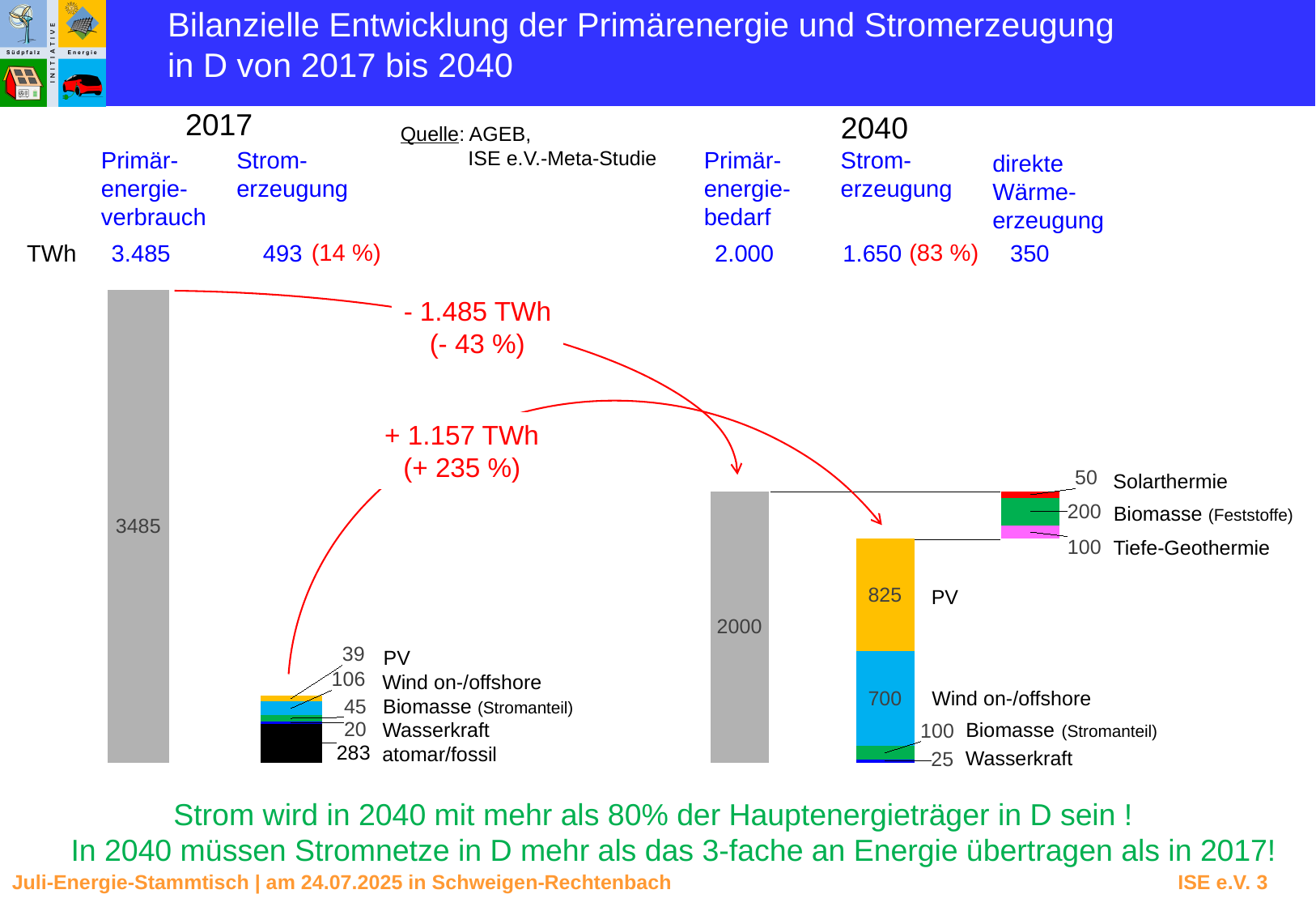
How many segments make up the 2040 electricity generation stacked bar? 4 What kind of chart is shown on the slide? Stacked bar chart In the 2040 electricity generation stacked bar, what is the value for Wind on-/offshore? 700 Which segment is the largest in the 2017 electricity generation stacked bar? atomar/fossil What is the difference between the PV value in 2040 and the PV value in 2017? 786 Which is larger in the 2040 direct heat generation bar: Biomasse (Feststoffe) or Tiefe-Geothermie? Biomasse (Feststoffe) In the 2017 electricity generation stacked bar, what is the value for atomar/fossil? 283 What is the total of the 2040 direct heat generation stacked bar (Solarthermie, Biomasse, Tiefe-Geothermie)? 350 What value is printed on the grey bar for primary energy consumption in 2017? 3485 What value is printed on the grey bar for primary energy demand in 2040? 2000 Which segment is the smallest in the 2017 electricity generation stacked bar? Wasserkraft In the 2040 electricity generation stacked bar, what is the value for PV? 825